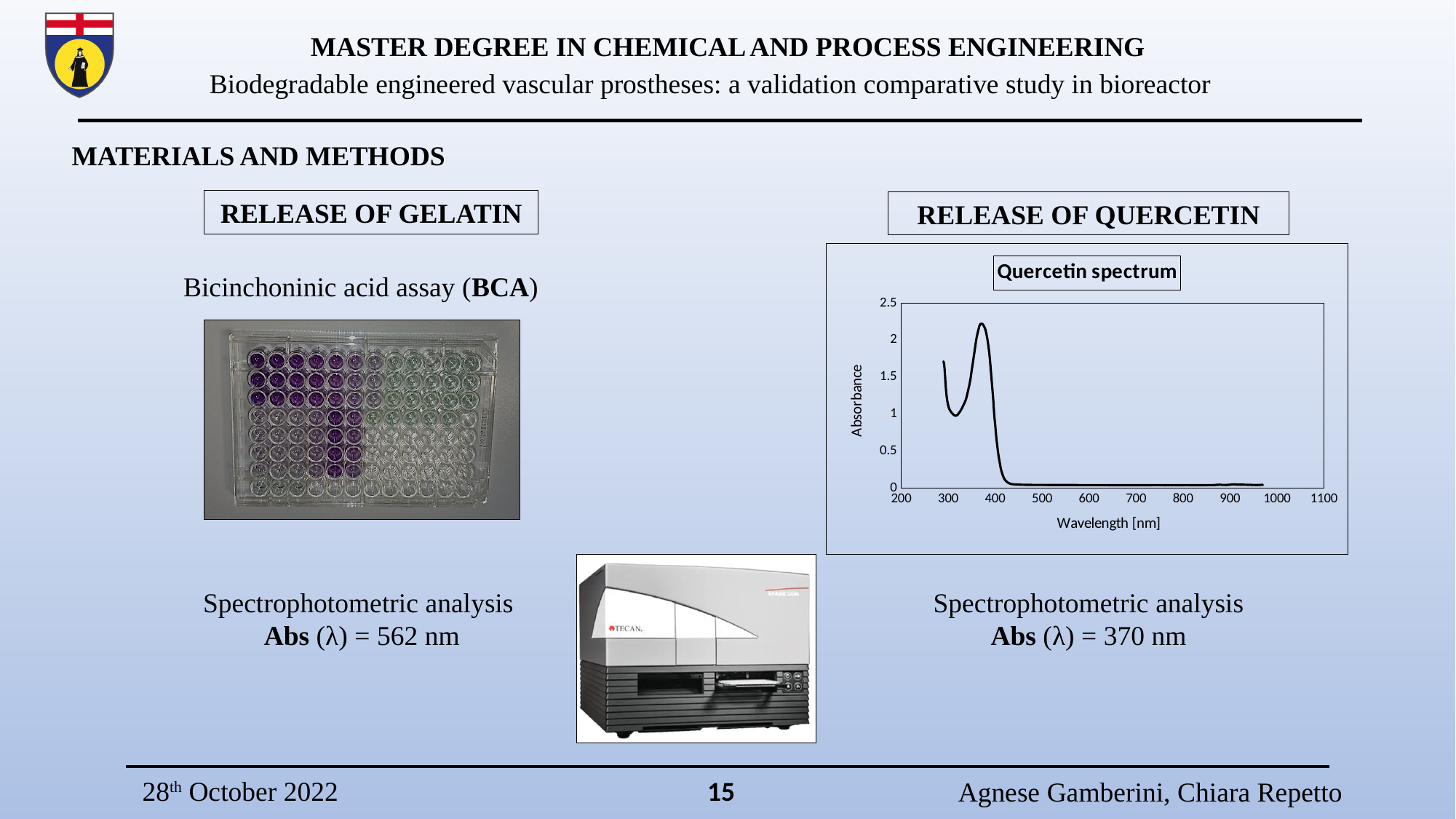
In the Quercetin spectrum chart, is the absorbance at 600 nm greater or less than 1? less What kind of chart is the Quercetin spectrum chart? line chart In the Quercetin spectrum chart, does the absorbance rise or fall between 400 nm and 500 nm? fall In the Quercetin spectrum chart, is the absorbance at 300 nm greater or less than 1.5? less What is the title of the chart on the slide? Quercetin spectrum What is the label of the x axis of the Quercetin spectrum chart? Wavelength [nm] In the Quercetin spectrum chart, is the absorbance higher at 400 nm or at 700 nm? 400 nm In the Quercetin spectrum chart, is the absorbance at 300 nm greater or less than 0.5? greater In the Quercetin spectrum chart, does the absorbance rise or fall between 320 nm and 370 nm? rise What is the highest value shown on the y axis of the Quercetin spectrum chart? 2.5